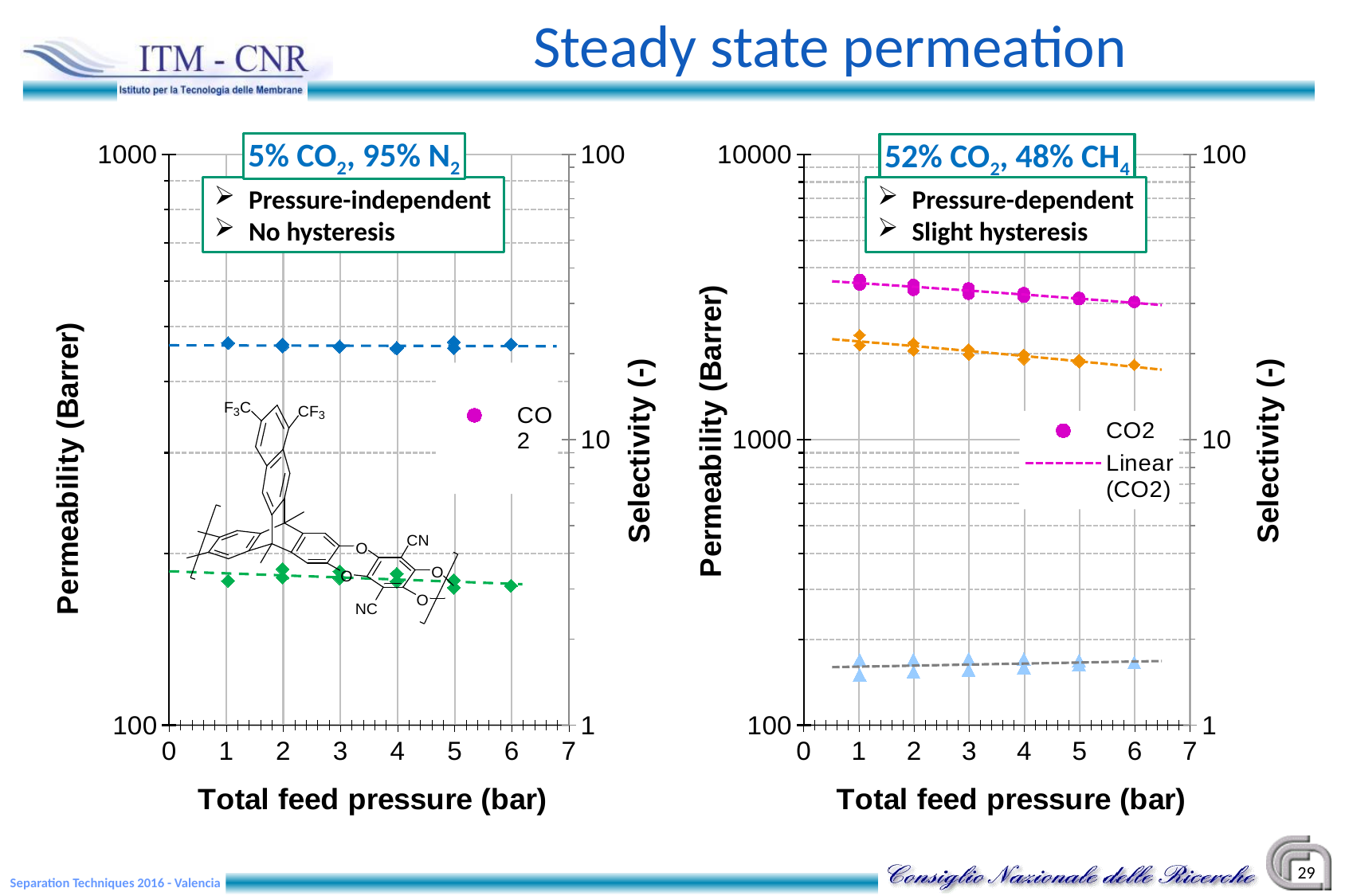
How many entries does the legend of the right chart titled "52% CO2, 48% CH4" list? 2 In the left chart titled "5% CO2, 95% N2", how many feed pressure values have data points plotted? 6 In the right chart titled "52% CO2, 48% CH4", which series has higher values at 1 bar: the magenta circles or the orange diamonds? magenta circles In the right chart titled "52% CO2, 48% CH4", is the value of the light blue triangle series at 3 bar greater or less than 1000? less In the right chart titled "52% CO2, 48% CH4", do the magenta CO2 permeability values rise or fall as total feed pressure increases? fall In the left chart titled "5% CO2, 95% N2", which series has higher values: the blue diamonds or the green diamonds? blue diamonds What type of chart is the left chart titled "5% CO2, 95% N2"? scatter chart In the right chart titled "52% CO2, 48% CH4", is the CO2 permeability at 1 bar greater or less than 1000 Barrer? greater What is the x-axis label of the right chart titled "52% CO2, 48% CH4"? Total feed pressure (bar) In the right chart titled "52% CO2, 48% CH4", how many feed pressure values have data points plotted? 6 What is the label of the right-hand secondary y-axis on the left chart titled "5% CO2, 95% N2"? Selectivity (-)